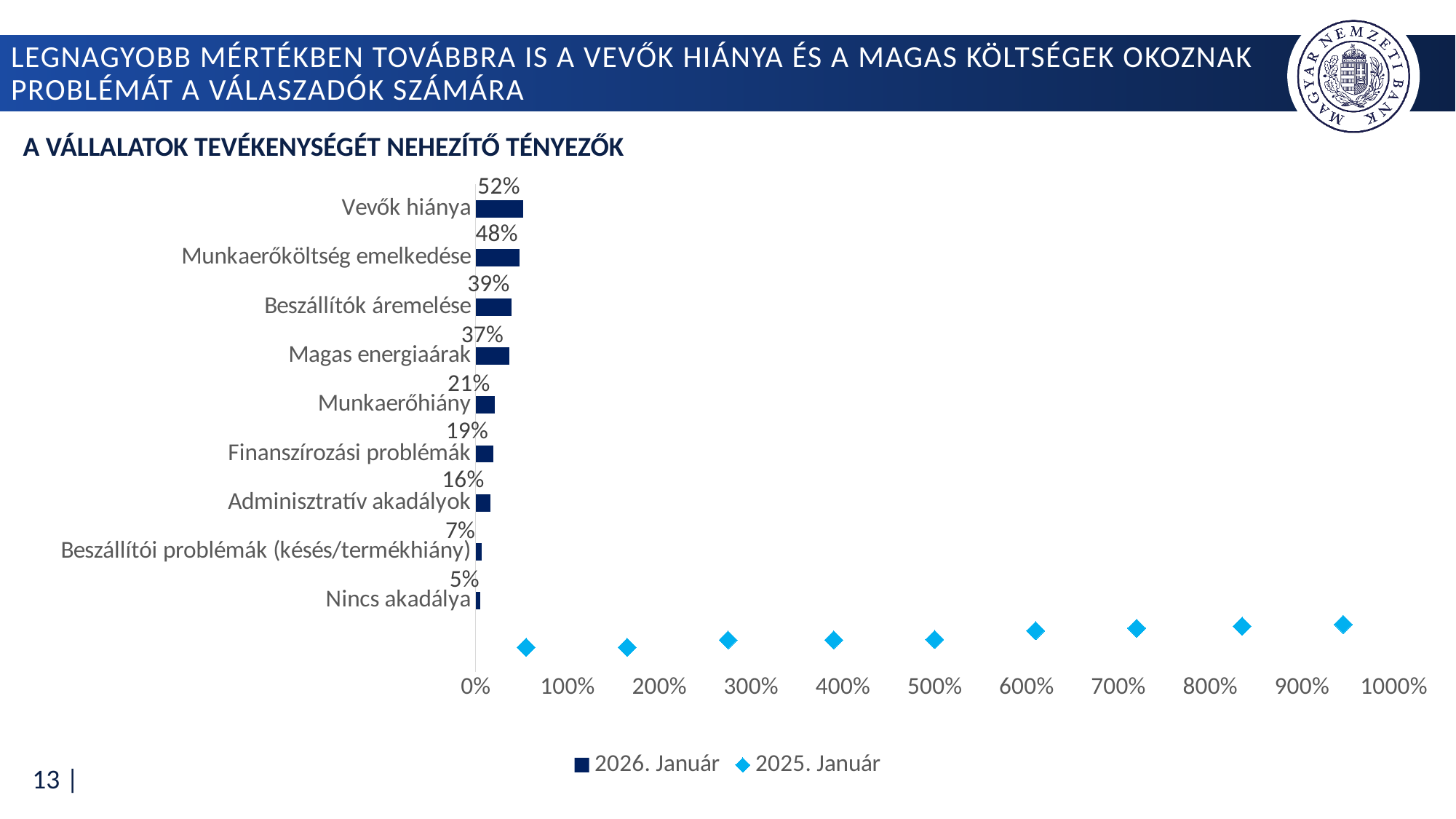
What is the value for Magas energiaárak in the 2026. Január series? 37% What is the difference between the 2026. Január values for Vevők hiánya and Munkaerőköltség emelkedése? 4% How many categories are shown on the chart? 9 What is the value for Adminisztratív akadályok in the 2026. Január series? 16% How many series does the legend list? 2 What is the value for Vevők hiánya in the 2026. Január series? 52% What kind of chart is shown on the slide? Bar chart What is the title of the chart? A vállalatok tevékenységét nehezítő tényezők In the 2026. Január series, which is larger: Beszállítók áremelése or Finanszírozási problémák? Beszállítók áremelése What is the difference between the 2026. Január values for Munkaerőhiány and Beszállítói problémák (késés/termékhiány)? 14% Which category has the lowest value in the 2026. Január series? Nincs akadálya Which category has the highest value in the 2026. Január series? Vevők hiánya